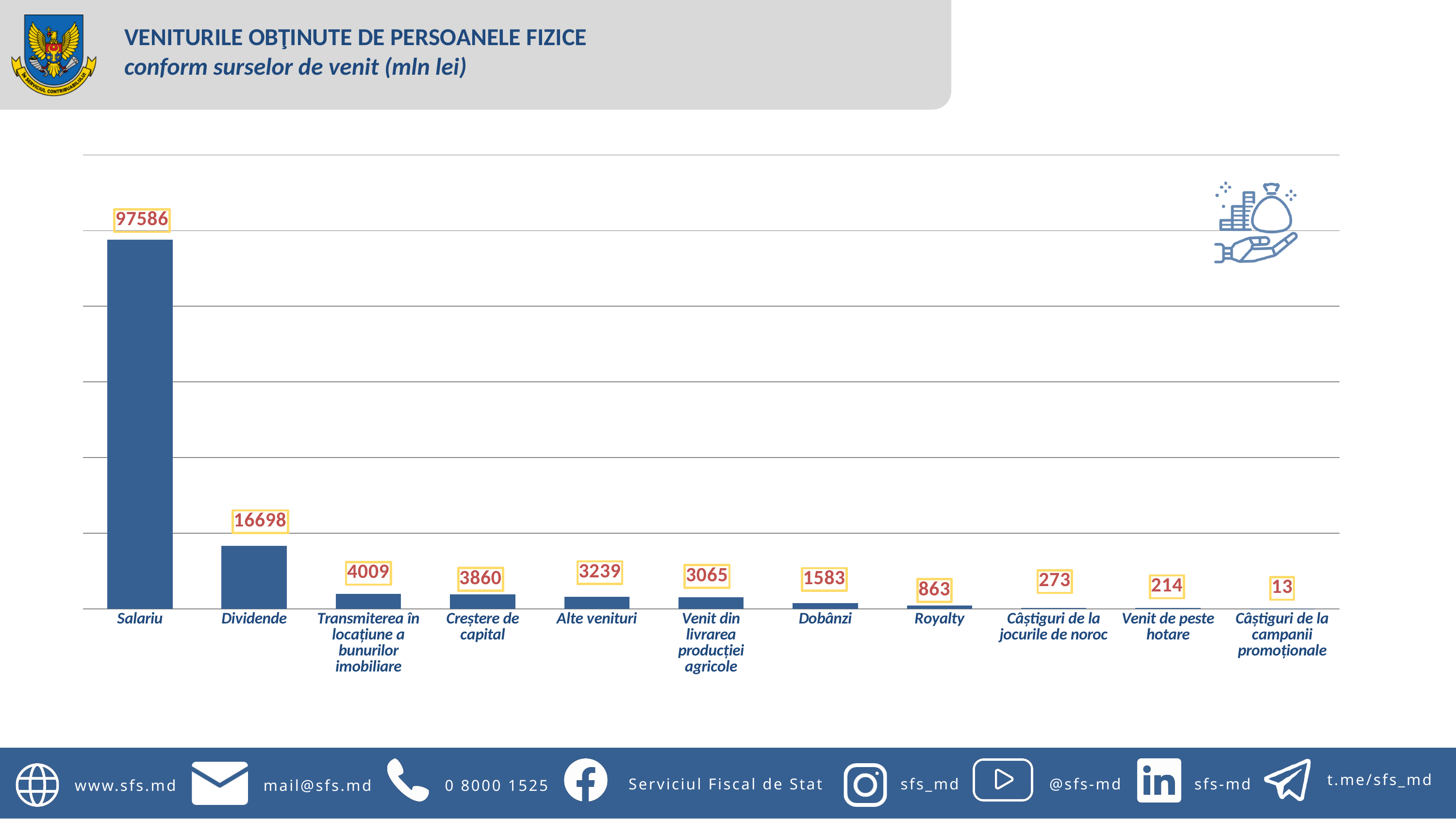
Which is larger, the value for Royalty or the value for Câștiguri de la jocurile de noroc? Royalty Do the values rise or fall from left to right along the x axis? Fall What is the value for Venit de peste hotare? 214 What kind of chart is shown on the slide? Bar chart What is the value for Dobânzi? 1583 How many categories are shown on the chart? 11 What is the value for Dividende? 16698 What is the value for Salariu? 97586 What is the difference between the values for Creștere de capital and Alte venituri? 621 What is the difference between the values for Salariu and Dividende? 80888 Which category has the highest value? Salariu Which category has the lowest value? Câștiguri de la campanii promoționale